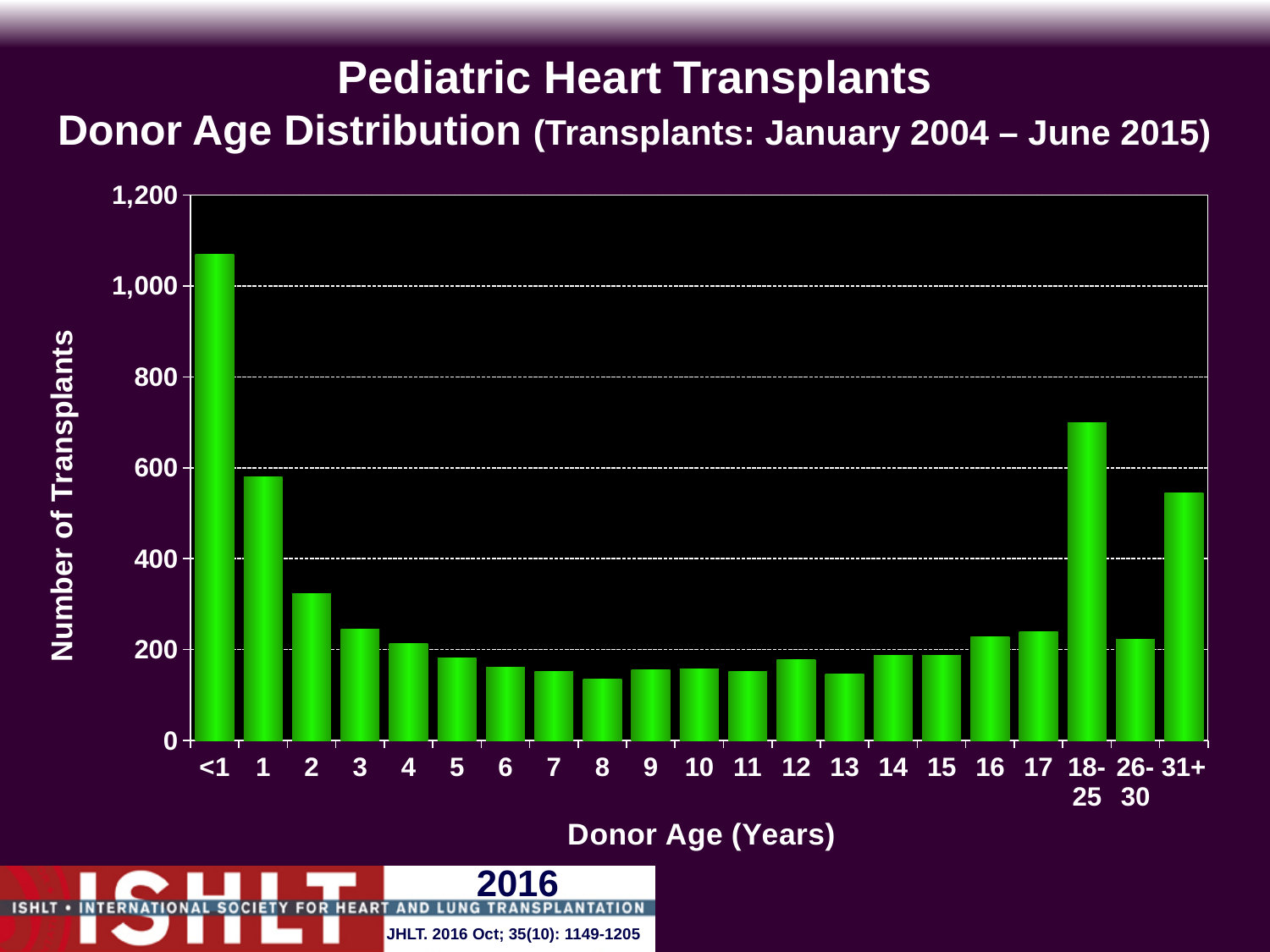
Is the number of transplants for donor age 1 greater or less than 600? less What is the label of the y axis? Number of Transplants How many donor age categories are shown on the x axis? 21 Is the number of transplants for donor age 31+ greater or less than 600? less Do the number of transplants rise or fall from donor age <1 to donor age 8? fall Is the number of transplants for donor age 18-25 greater or less than 600? greater Which donor age category has the highest number of transplants? <1 What kind of chart is shown on the slide? bar chart Which has more transplants: donor age 18-25 or donor age 31+? 18-25 Which has more transplants: donor age 1 or donor age 2? 1